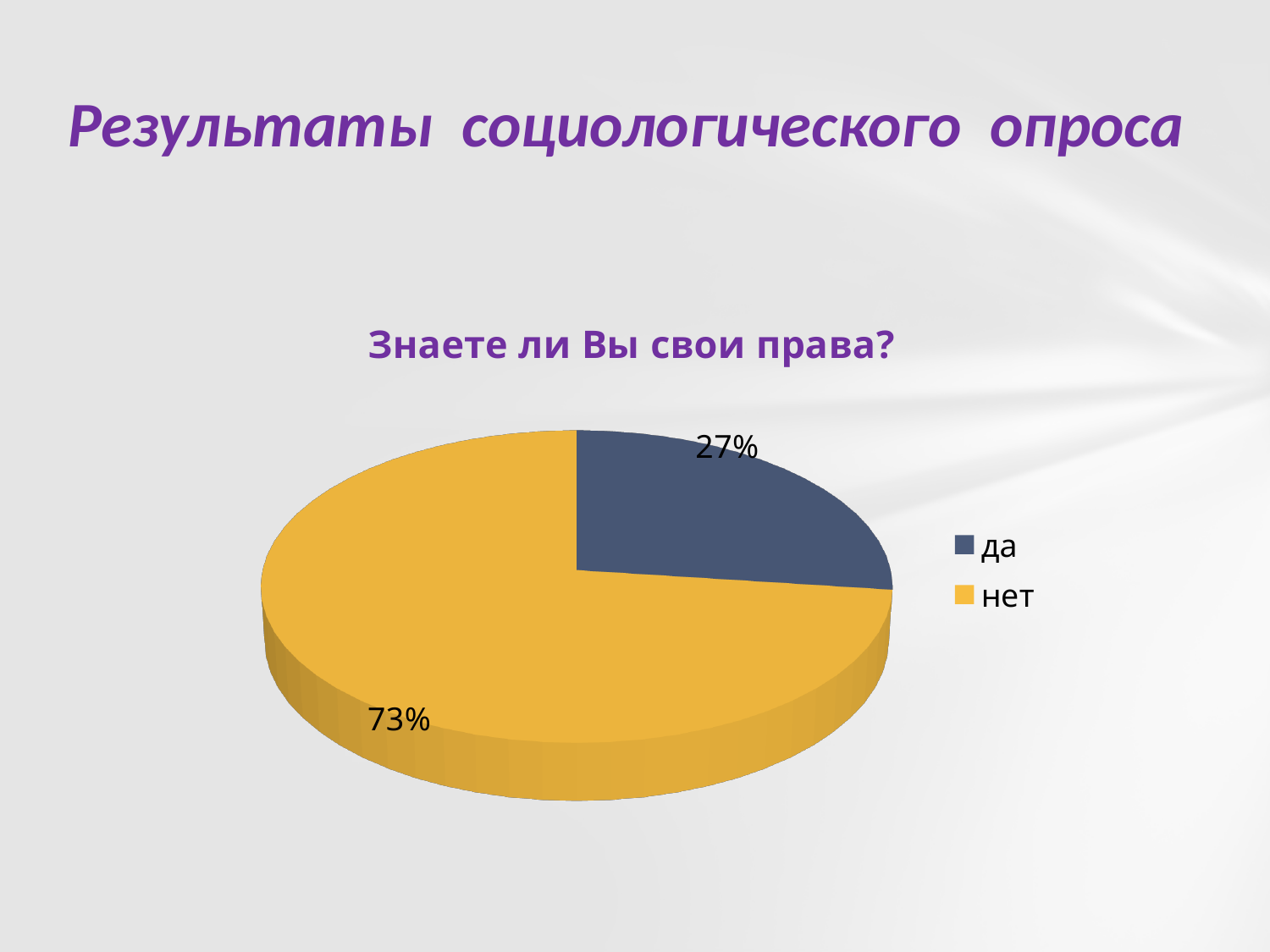
What kind of chart is shown on the slide? pie chart What is the title of the chart? Знаете ли Вы свои права? How many entries does the legend list? 2 Which is larger, the share for "да" or the share for "нет"? нет Which answer has the smallest share of the pie? да What is the difference in percentage points between "нет" and "да"? 46 What percentage of respondents answered "да"? 27% What colour is the slice for "нет"? yellow Which answer has the largest share of the pie? нет How many slices does the pie chart have? 2 What percentage of respondents answered "нет"? 73% What is the share of the pie for "да"? 27%